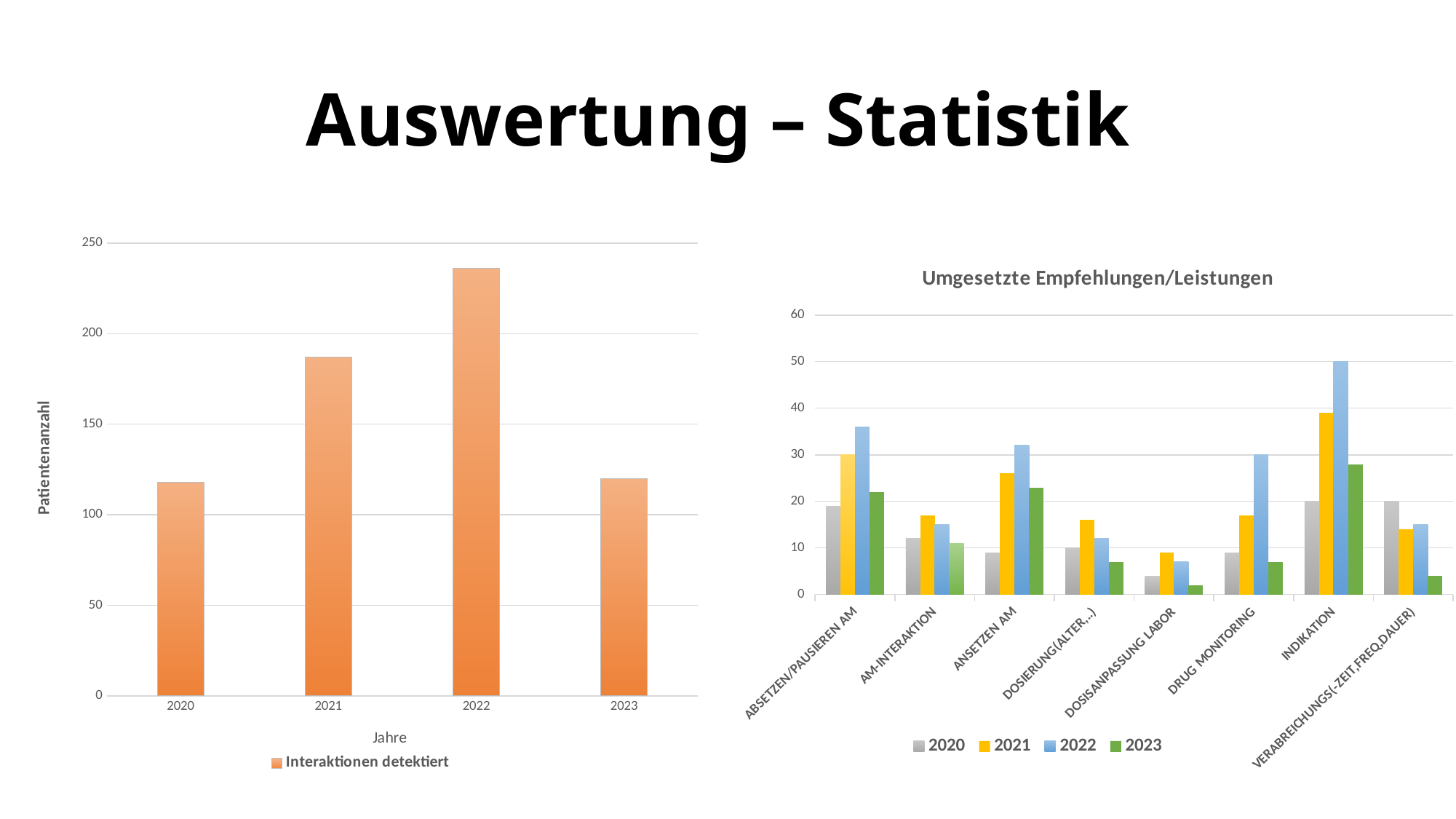
In the right chart (Umgesetzte Empfehlungen/Leistungen), is the 2022 value for DRUG MONITORING greater or less than 20? greater In the left chart (Interaktionen detektiert), which year has the highest value? 2022 What kind of chart is the left chart (Interaktionen detektiert)? bar chart In the left chart (Interaktionen detektiert), is the value for 2022 greater or less than 200? greater In the right chart (Umgesetzte Empfehlungen/Leistungen), which category has the highest value for the 2022 series? INDIKATION In the left chart (Interaktionen detektiert), which is larger, the value for 2021 or the value for 2023? 2021 How many years are shown on the x axis of the left chart (Interaktionen detektiert)? 4 In the right chart (Umgesetzte Empfehlungen/Leistungen), for ABSETZEN/PAUSIEREN AM, which is larger, the 2021 value or the 2022 value? 2022 In the left chart (Interaktionen detektiert), is the value for 2021 greater or less than 150? greater In the right chart (Umgesetzte Empfehlungen/Leistungen), how many series does the legend list? 4 How many categories are shown on the x axis of the right chart (Umgesetzte Empfehlungen/Leistungen)? 8